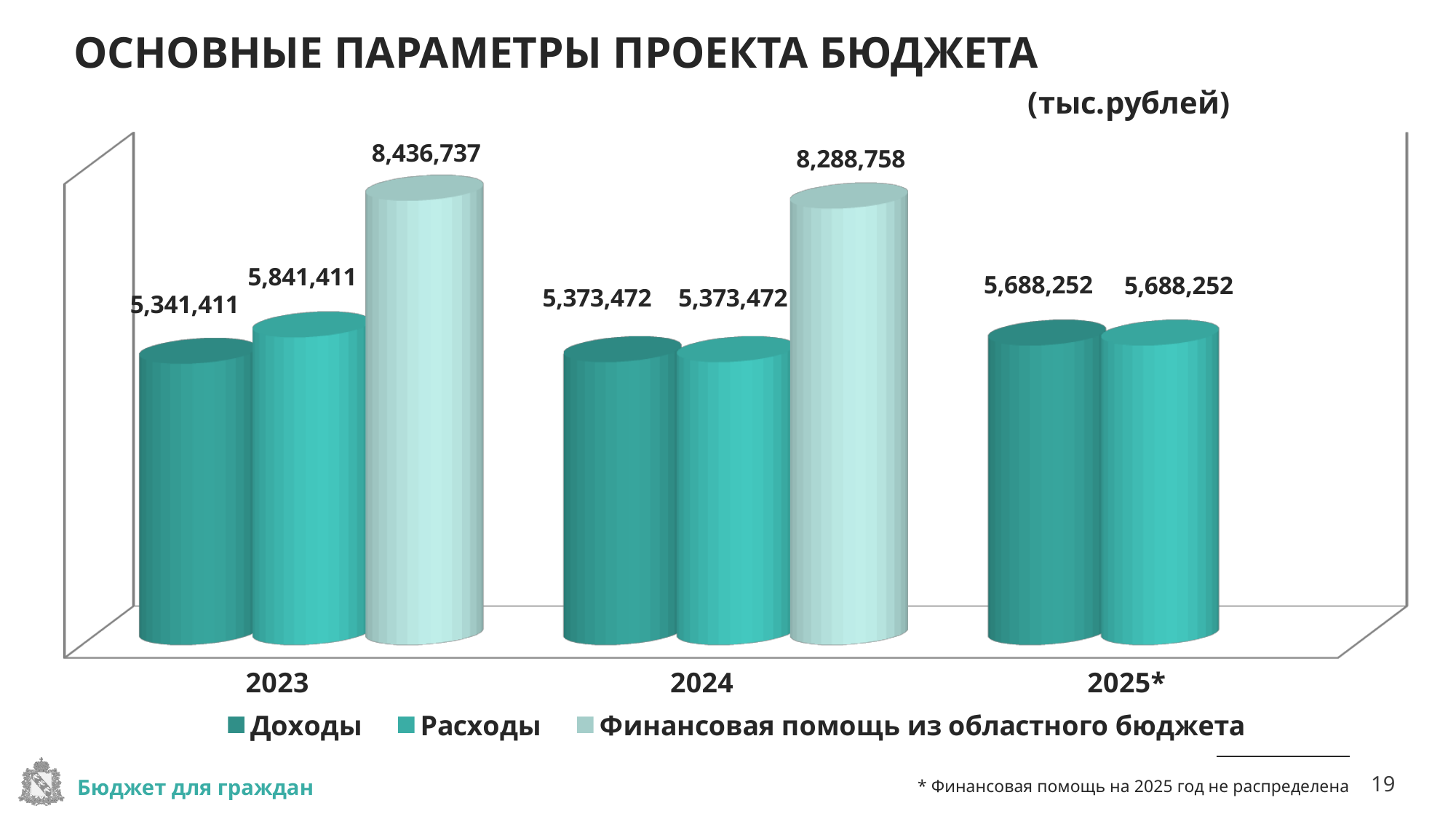
In which year is Финансовая помощь из областного бюджета highest? 2023 What is the value of Доходы for 2023? 5,341,411 What is the value of Расходы for 2025*? 5,688,252 By how much does Финансовая помощь из областного бюджета in 2023 exceed that in 2024? 147,979 What kind of chart is shown on the slide? Bar chart How many years are shown on the x axis? 3 In which year is Доходы lowest? 2023 What is the difference between Расходы and Доходы in 2023? 500,000 Do the values for Доходы rise or fall from 2023 to 2025*? Rise How many series does the legend list? 3 What is the value of Финансовая помощь из областного бюджета for 2024? 8,288,758 Which is larger in 2023: Доходы or Расходы? Расходы